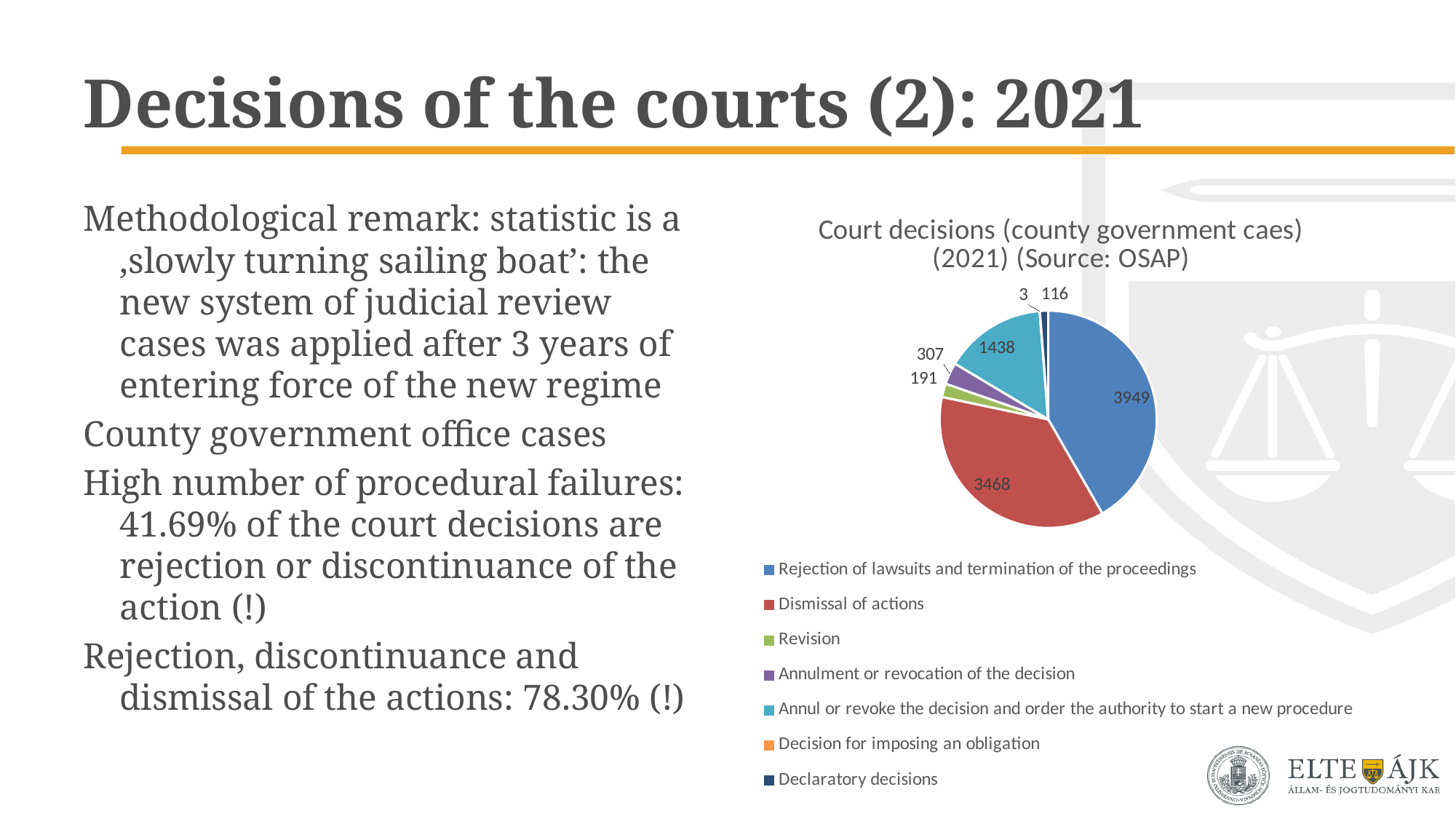
What is the value for 'Annul or revoke the decision and order the authority to start a new procedure' in the pie chart? 1438 How many categories does the pie chart have? 7 Which category has the smallest slice in the pie chart? Decision for imposing an obligation Which category has the largest slice in the pie chart? Rejection of lawsuits and termination of the proceedings What is the value for 'Declaratory decisions' in the pie chart? 116 What is the value for 'Dismissal of actions' in the pie chart? 3468 What type of chart is shown on the slide? pie chart What is the difference between the values for 'Rejection of lawsuits and termination of the proceedings' and 'Dismissal of actions'? 481 What is the title of the pie chart? Court decisions (county government caes) (2021) (Source: OSAP) What is the value for 'Rejection of lawsuits and termination of the proceedings' in the pie chart? 3949 Which is larger: the value for 'Annulment or revocation of the decision' or the value for 'Revision'? Annulment or revocation of the decision What share of the pie does 'Rejection of lawsuits and termination of the proceedings' represent? 41.69%